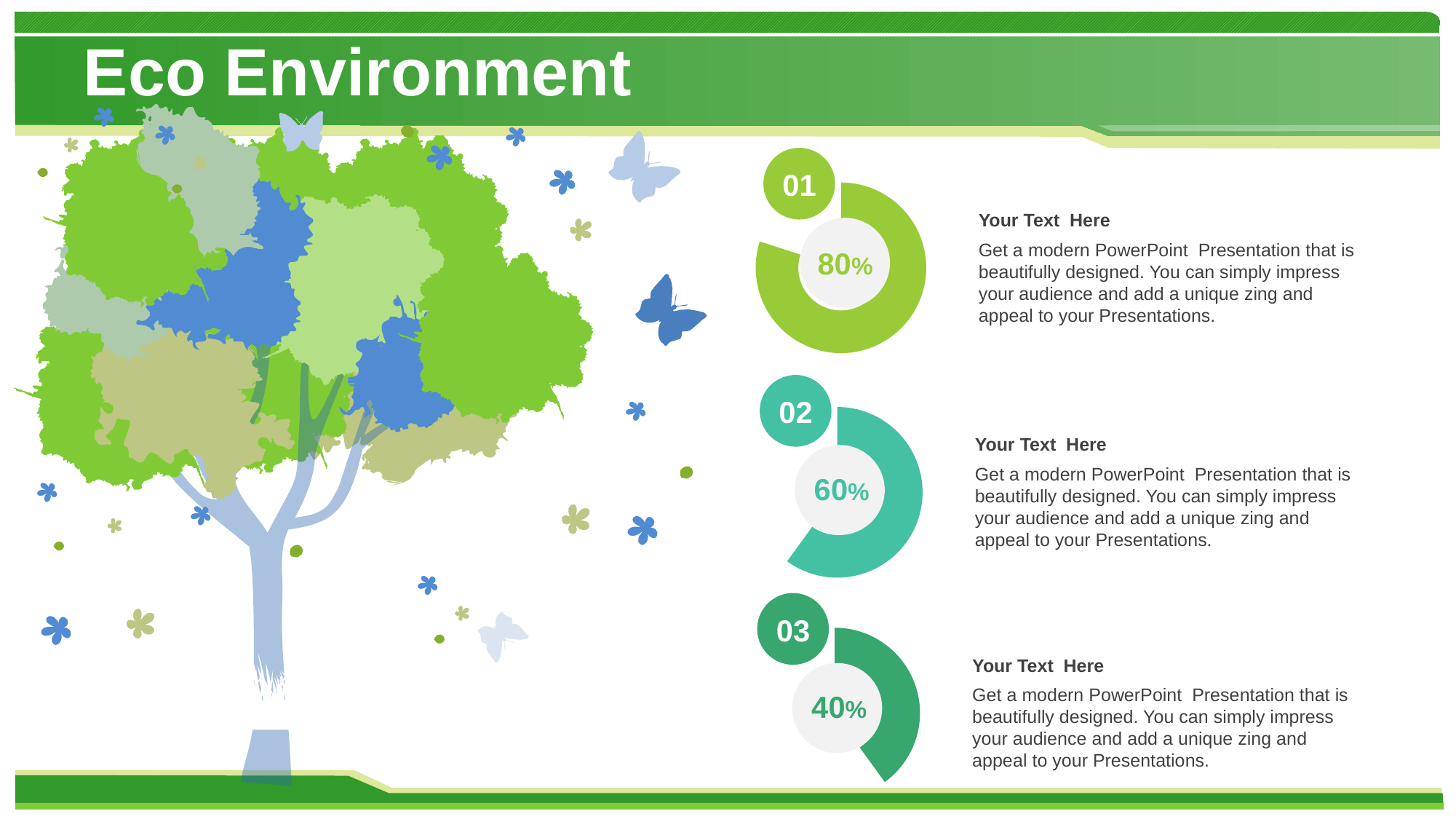
What is the difference between the percentages in the charts labelled 01 and 03? 40% What percentage is shown in the ring chart labelled 02? 60% Which of the three ring charts shows the lowest percentage? 03 How many ring charts are shown on the slide? 3 Which of the three ring charts shows the highest percentage? 01 What kind of chart is used to display the percentages on the slide? Donut (ring) chart Which shows a larger percentage, the chart labelled 02 or the chart labelled 03? 02 What percentage is shown in the ring chart labelled 01? 80% What is the difference between the percentages in the charts labelled 01 and 02? 20% What is the title of the slide containing the ring charts? Eco Environment What percentage is shown in the ring chart labelled 03? 40% Do the percentages increase or decrease going from the top chart (01) to the bottom chart (03)? Decrease